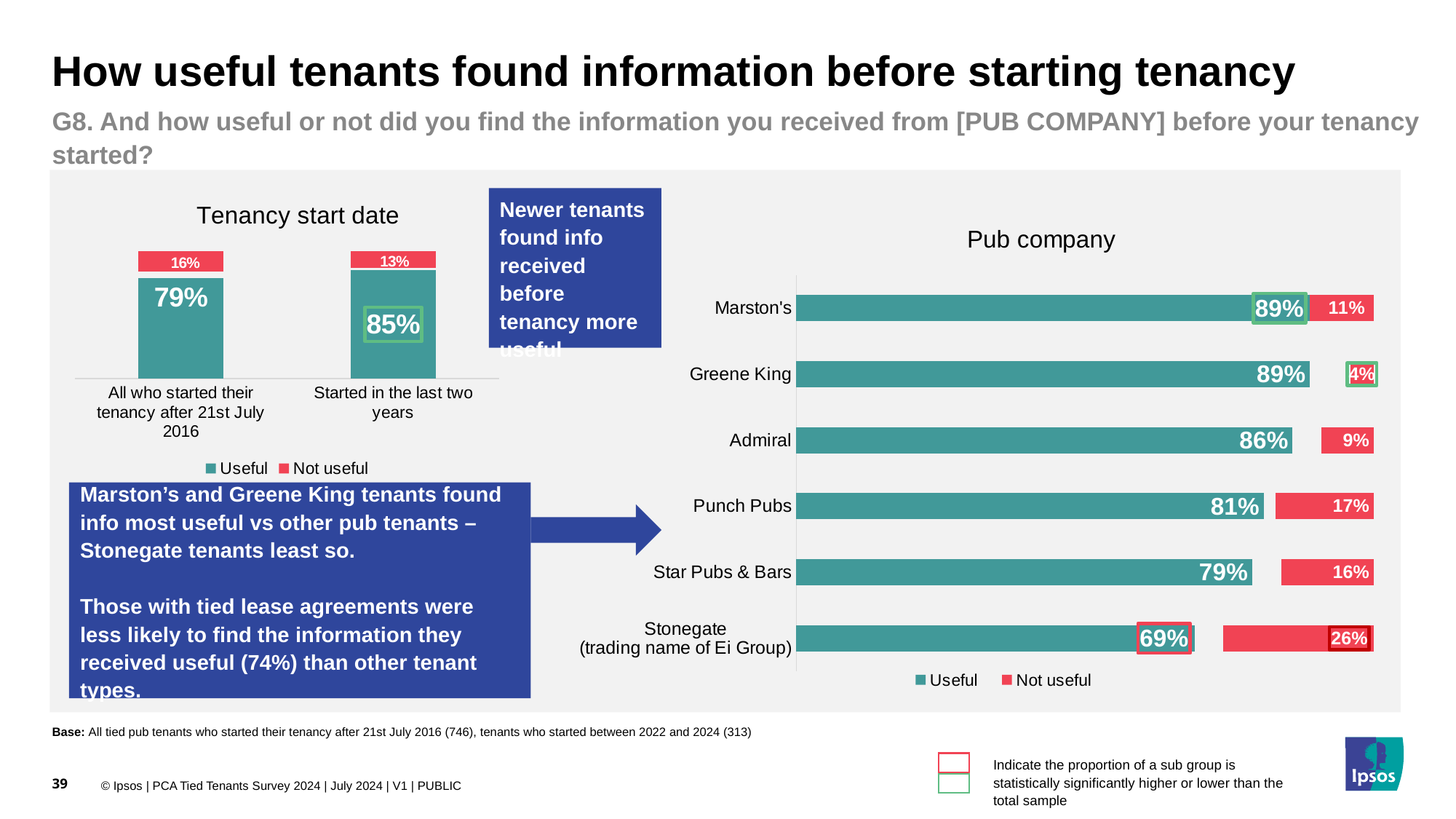
In the 'Pub company' chart, what is the difference between the 'Useful' values for Marston's and Stonegate? 20 percentage points What type of chart is the 'Pub company' chart? Bar chart In the 'Pub company' chart, what is the 'Useful' value for Admiral? 86% In the 'Pub company' chart, which pub company has the highest 'Not useful' value? Stonegate (trading name of Ei Group) In the 'Pub company' chart, what is the 'Not useful' value for Punch Pubs? 17% In the 'Pub company' chart, which has a larger 'Not useful' value, Greene King or Admiral? Admiral How many series does the legend of the 'Pub company' chart list? 2 In the 'Pub company' chart, which pub company has the lowest 'Useful' value? Stonegate (trading name of Ei Group) How many pub companies are shown in the 'Pub company' chart? 6 In the 'Tenancy start date' chart, what is the 'Not useful' value for all who started their tenancy after 21st July 2016? 16% In the 'Tenancy start date' chart, what is the 'Useful' value for tenants who started in the last two years? 85% In the 'Tenancy start date' chart, what is the difference between the 'Useful' values for the two groups? 6 percentage points